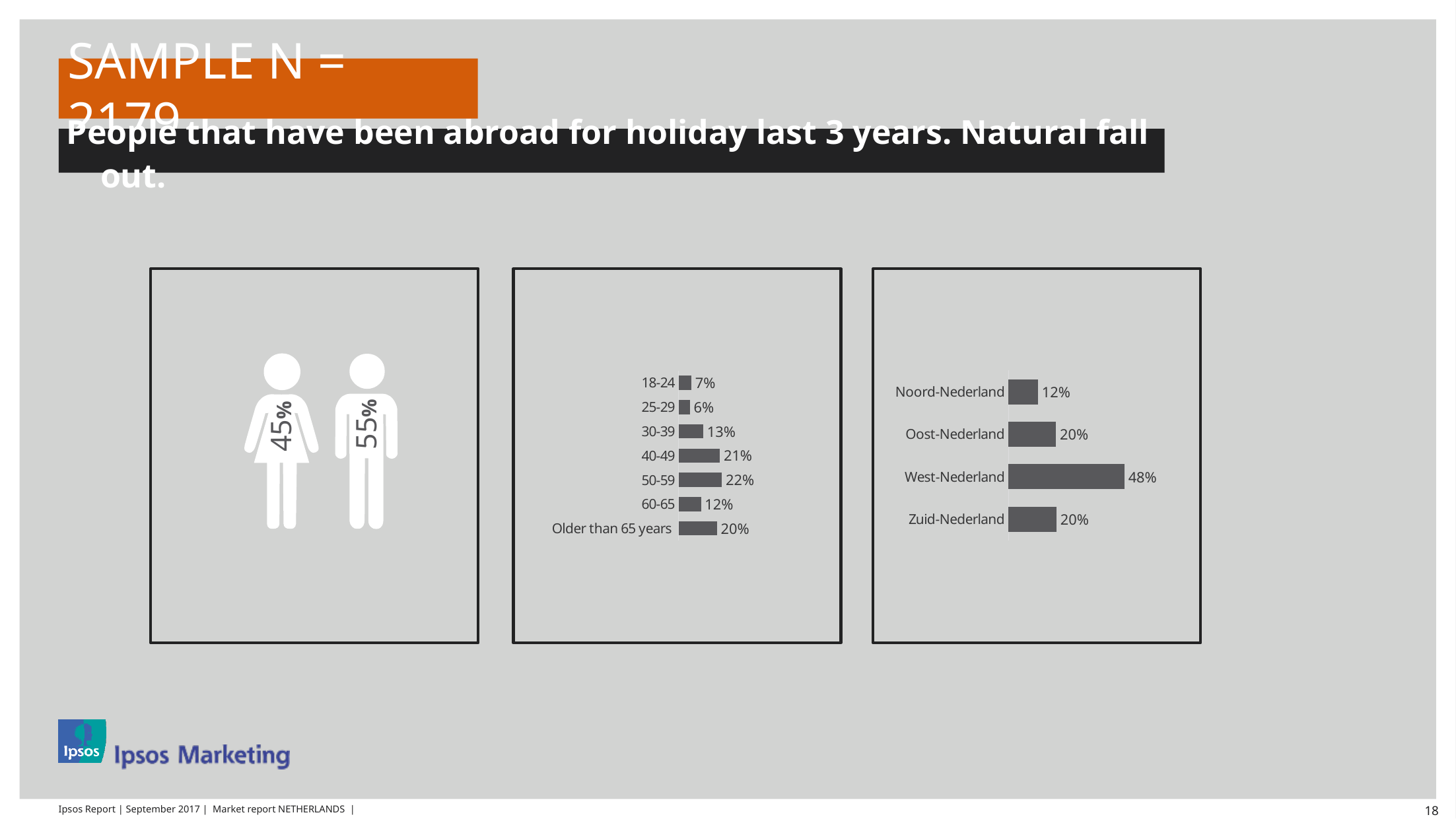
In the right-hand chart (regions), which region has the lowest value? Noord-Nederland In the middle chart (age groups), what is the value for Older than 65 years? 20% In the right-hand chart (regions), what is the difference between West-Nederland and Oost-Nederland? 28% In the middle chart (age groups), what is the value for 50-59? 22% In the right-hand chart (regions), which is larger, the value for Noord-Nederland or Zuid-Nederland? Zuid-Nederland In the middle chart (age groups), which age group has the highest value? 50-59 In the right-hand chart (regions), how many regions are shown? 4 What kind of chart is the right-hand chart showing the regions? Bar chart In the middle chart (age groups), how many age categories are shown? 7 In the middle chart (age groups), what is the difference between the values for 40-49 and 18-24? 14% In the right-hand chart (regions), what is the value for West-Nederland? 48% In the middle chart (age groups), which age group has the lowest value? 25-29